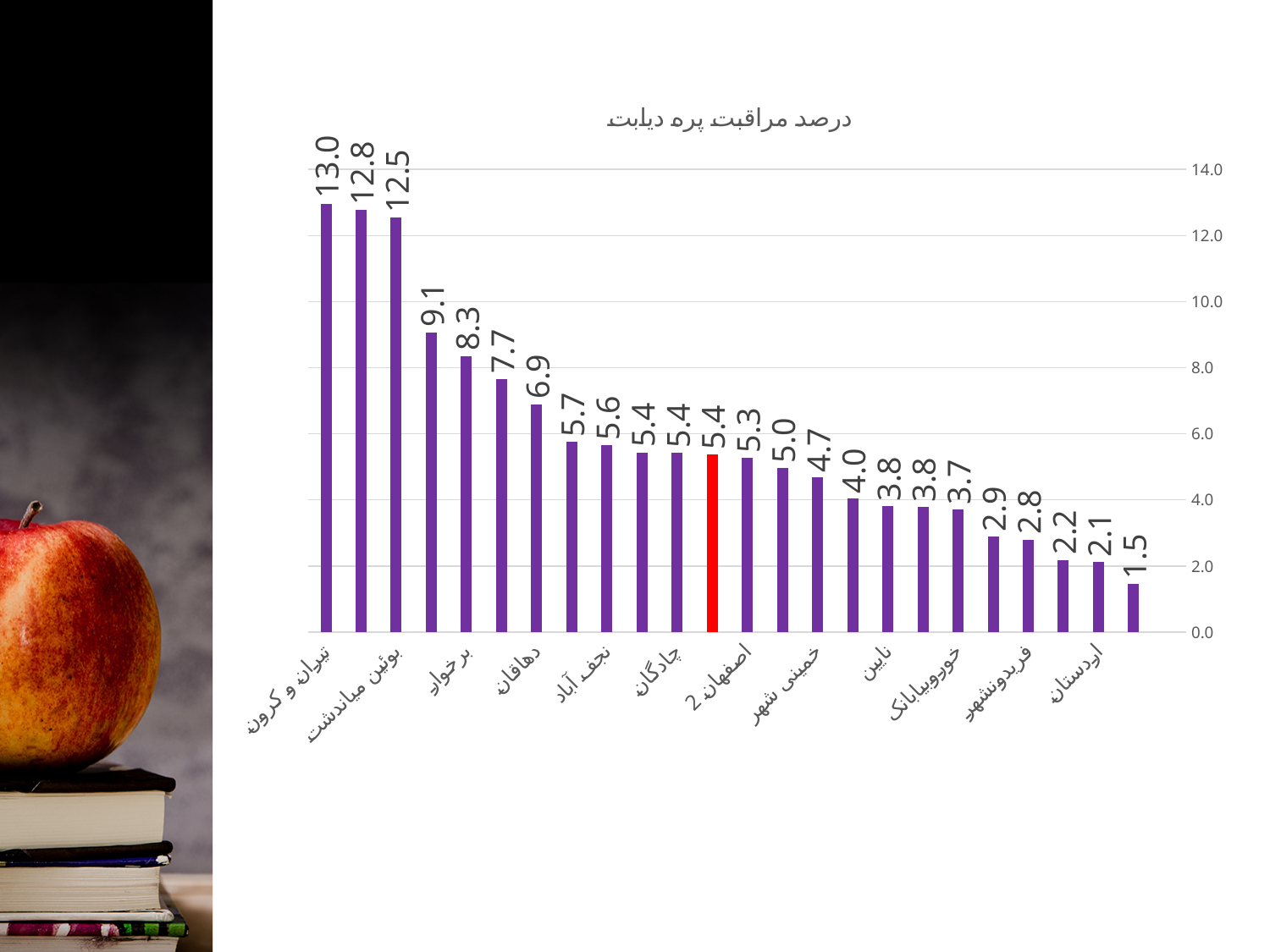
What is the value for تیران و کرون? 13.0 What is the highest value shown in the chart? 13.0 How many bars are plotted in the chart? 24 Is the value for برخوار greater or less than 8.0? greater Do the values rise or fall from left to right along the x axis? fall What kind of chart is shown on the slide? bar chart What is the value of the red bar in the chart? 5.4 Which category has the highest value in the chart? تیران و کرون What is the difference between the highest value (13.0) and the lowest value (1.5) in the chart? 11.5 What is the lowest value shown in the chart? 1.5 What is the value for بوئین میاندشت? 12.5 What is the title of the chart? درصد مراقبت پره دیابت